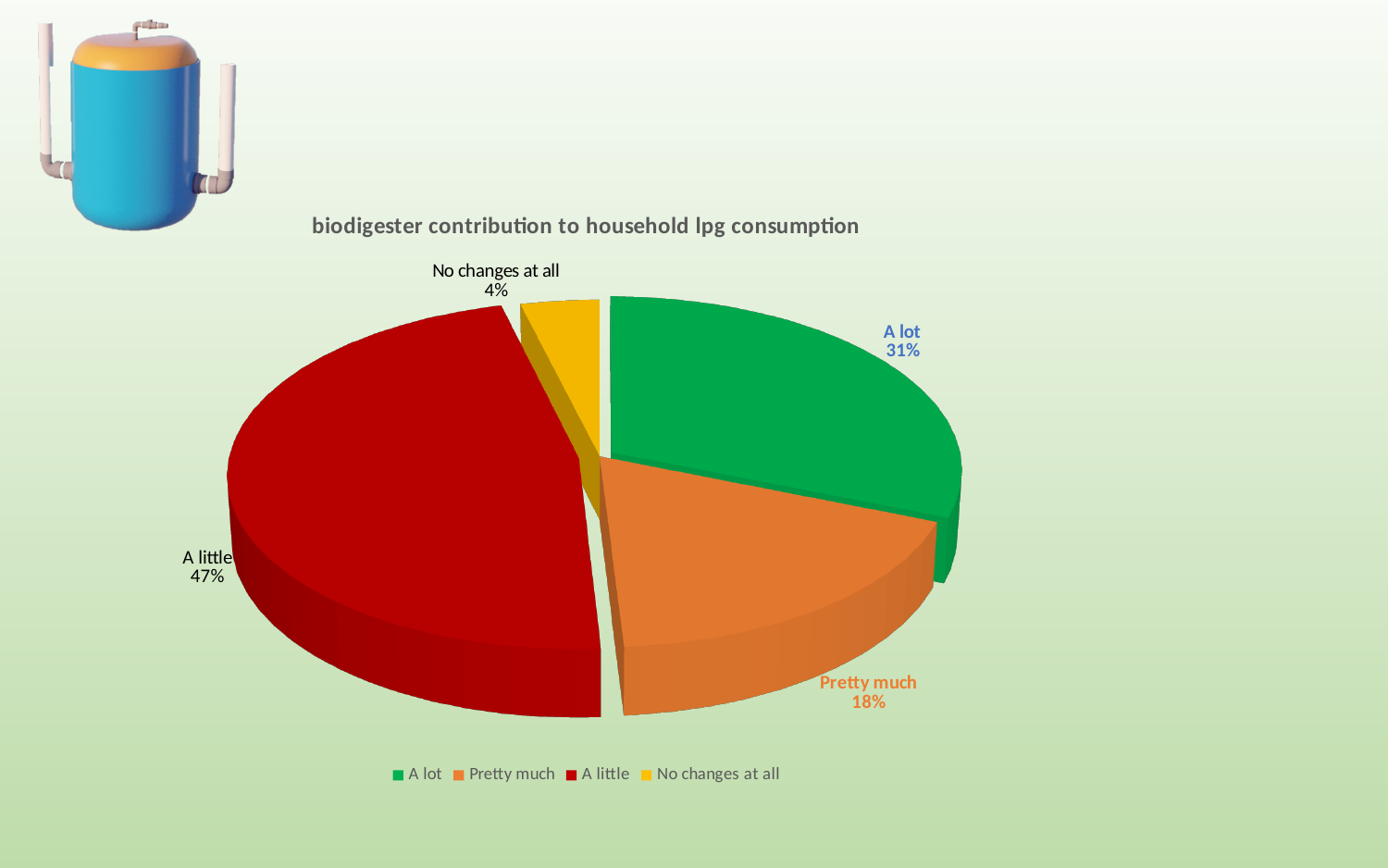
Which category has the smallest slice of the pie? No changes at all What colour is the slice for "No changes at all"? Yellow Which is larger, the share for "A lot" or the share for "Pretty much"? A lot What kind of chart is shown on the slide? Pie chart What share of the pie is labelled "A little"? 47% What is the title of the chart? biodigester contribution to household lpg consumption How many categories does the pie chart show? 4 What share of the pie is labelled "No changes at all"? 4% What share of the pie is labelled "A lot"? 31% Which category has the largest slice of the pie? A little What is the difference in percentage points between "A little" and "A lot"? 16